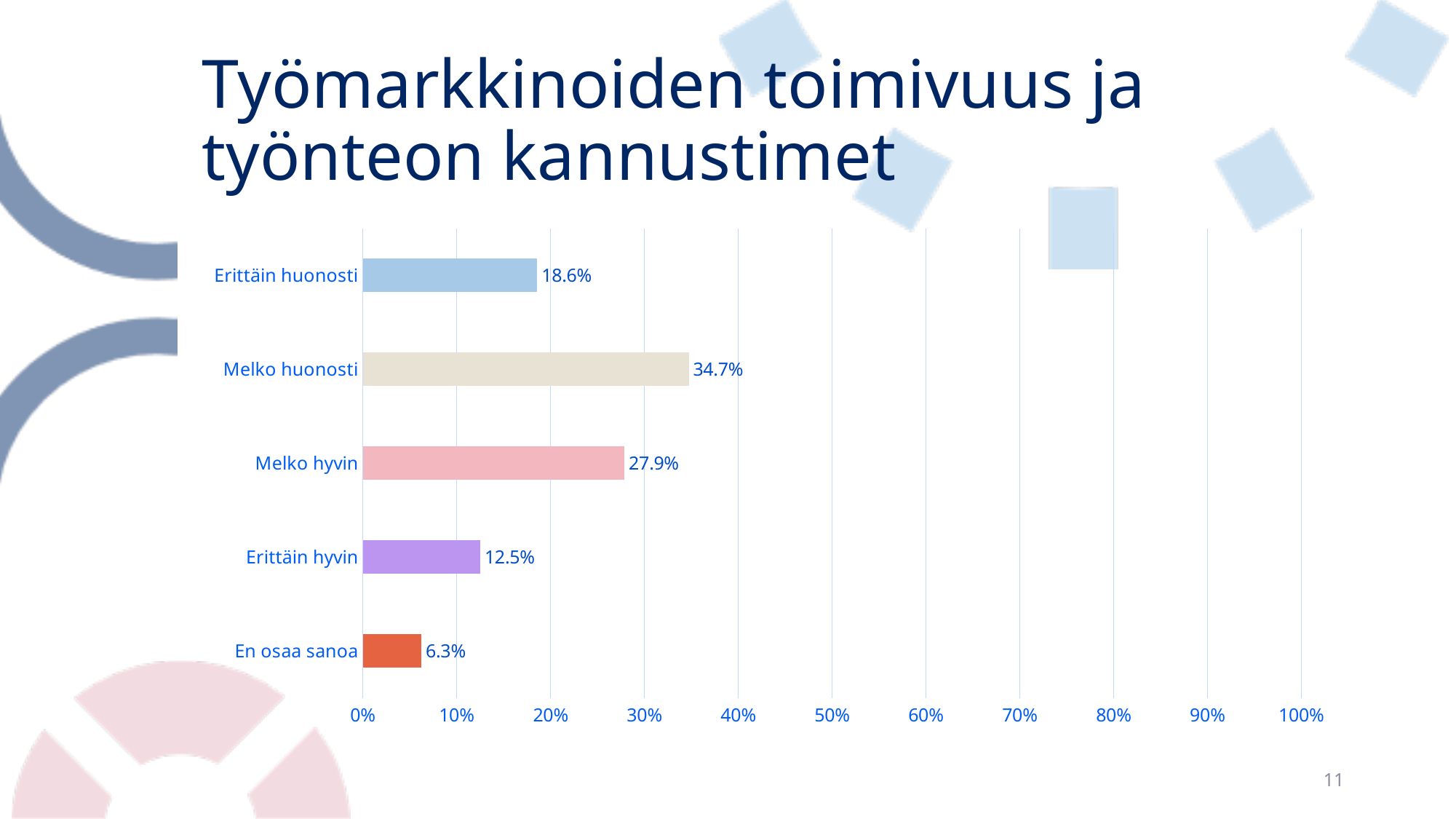
Which category has the lowest value? En osaa sanoa What is the difference between the values for Melko huonosti and Melko hyvin? 6.8% What is the value for Erittäin hyvin? 12.5% Is the value for Melko hyvin greater or less than 20%? greater What kind of chart is shown on the slide? Bar chart How many categories are shown in the chart? 5 What is the value for Melko hyvin? 27.9% What is the value for Melko huonosti? 34.7% Which category has the highest value? Melko huonosti What is the value for Erittäin huonosti? 18.6% What is the value for En osaa sanoa? 6.3% Which is larger, the value for Erittäin huonosti or the value for Erittäin hyvin? Erittäin huonosti